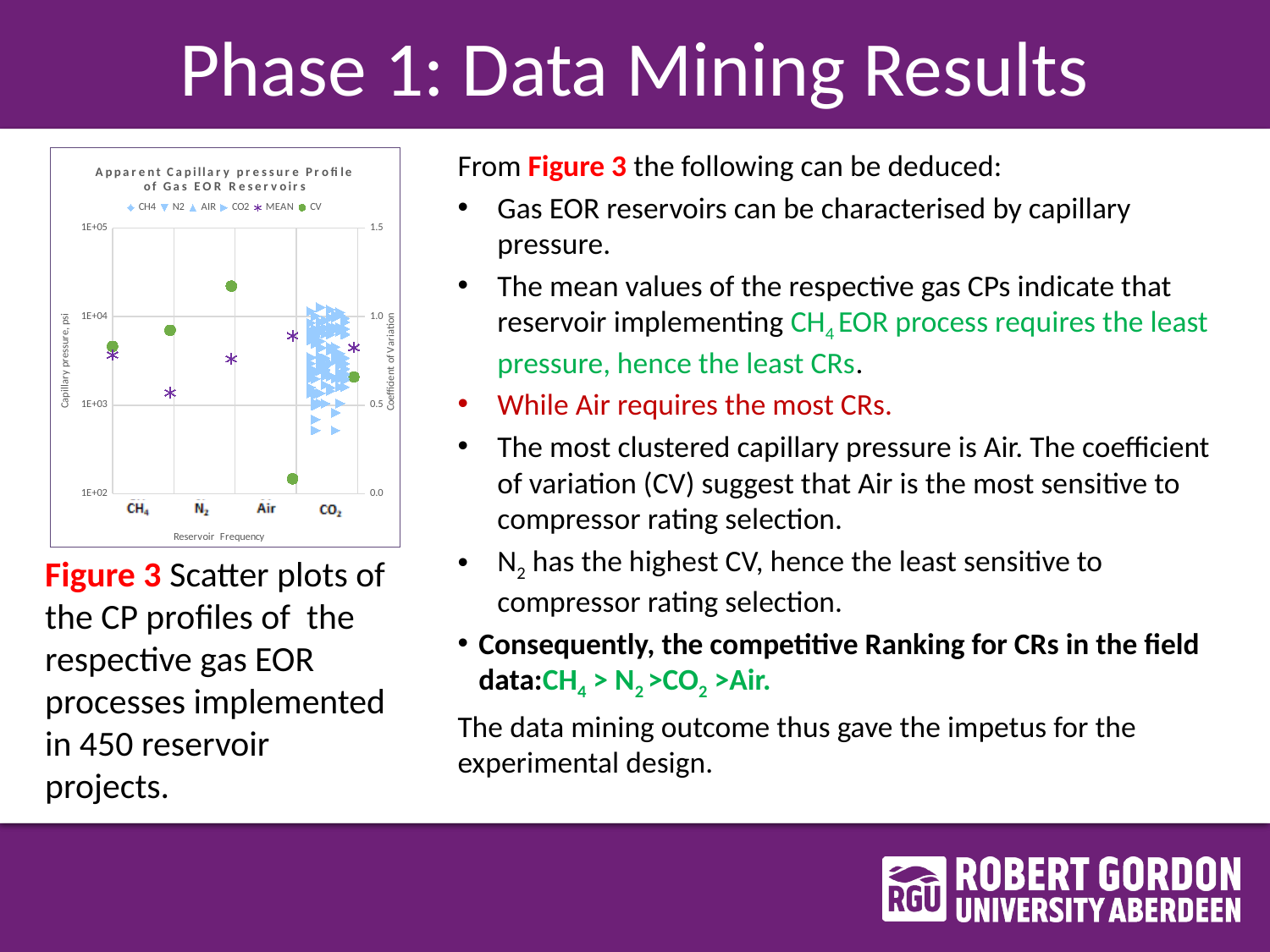
Is the MEAN capillary pressure for Air greater or less than 1E+04 psi? less Is the CV value for N2 greater or less than 1.0? greater Is the CV value for Air greater or less than 0.5? less What is the title of the chart on the slide? Apparent Capillary pressure Profile of Gas EOR Reservoirs How many gas categories are labelled along the x axis of the chart? 4 What is the label of the right-hand vertical axis of the chart? Coefficient of Variation Which gas has the lowest CV (coefficient of variation) value in the chart? Air How many series does the chart's legend list? 6 Which gas has the highest CV (coefficient of variation) value in the chart? N2 Which has the larger CV value, CH4 or CO2? CH4 What kind of chart is shown on the slide? Scatter plot